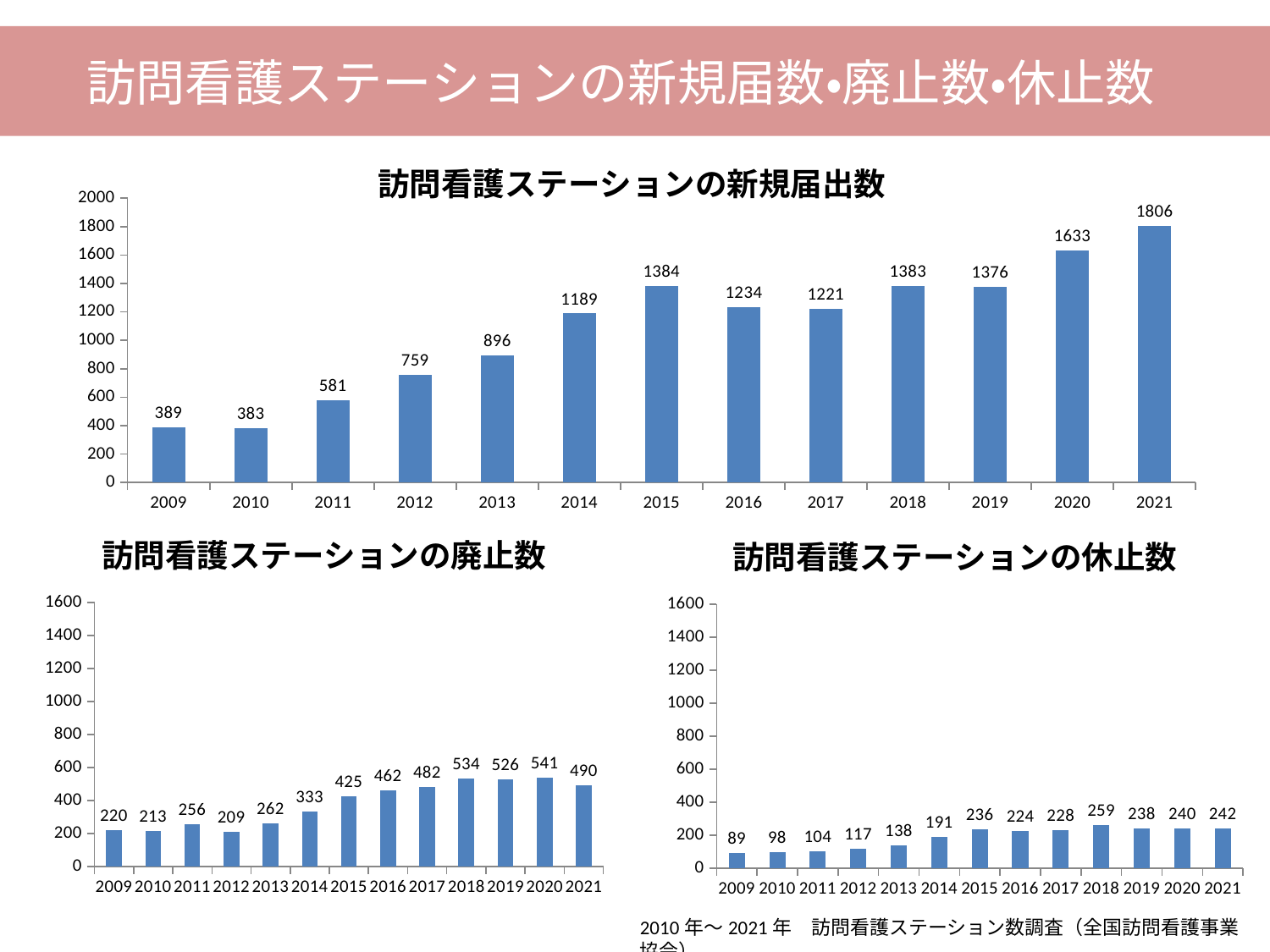
In the chart titled 訪問看護ステーションの休止数, what is the difference between the values for 2014 and 2013? 53 In the chart titled 訪問看護ステーションの新規届出数, what is the value for 2015? 1384 In the chart titled 訪問看護ステーションの廃止数, which is larger, the value for 2018 or the value for 2019? 2018 In the chart titled 訪問看護ステーションの新規届出数, what is the difference between the values for 2021 and 2020? 173 In the chart titled 訪問看護ステーションの廃止数, what is the value for 2020? 541 In the chart titled 訪問看護ステーションの新規届出数, which year has the lowest value? 2010 In the chart titled 訪問看護ステーションの休止数, what is the value for 2018? 259 In the chart titled 訪問看護ステーションの新規届出数, how many years are shown on the x axis? 13 In the chart titled 訪問看護ステーションの廃止数, which year has the lowest value? 2012 What kind of chart is the chart titled 訪問看護ステーションの休止数? bar chart In the chart titled 訪問看護ステーションの休止数, which year has the lowest value? 2009 In the chart titled 訪問看護ステーションの新規届出数, which year has the highest value? 2021